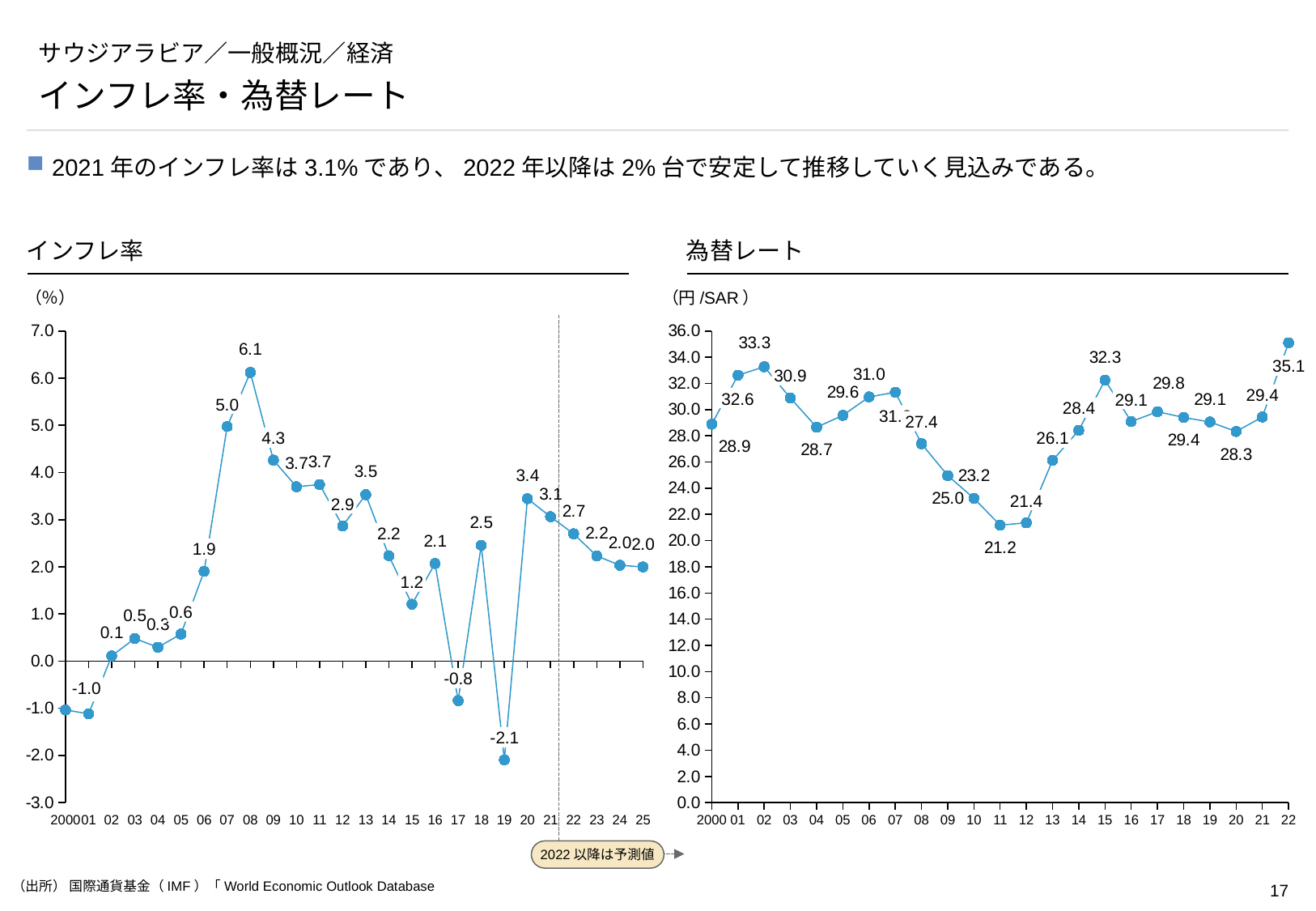
On the 為替レート chart, which is larger, the value for 2002 or the value for 2015? 2002 On the インフレ率 chart, what is the inflation rate value for 2008? 6.1 On the 為替レート chart, what is the value for 2022? 35.1 On the インフレ率 chart, what is the difference between the 2008 value and the 2007 value? 1.1 On the インフレ率 chart, what is the value for 2021? 3.1 On the 為替レート chart, what is the difference between the 2022 value and the 2011 value? 13.9 On the 為替レート chart, which year has the highest exchange rate? 2022 What kind of chart is the インフレ率 chart? line chart On the 為替レート chart, which year has the lowest exchange rate? 2011 On the インフレ率 chart, which year has the lowest inflation rate? 2019 What unit is shown on the 為替レート chart's axis? 円/SAR On the インフレ率 chart, which year has the highest inflation rate? 2008